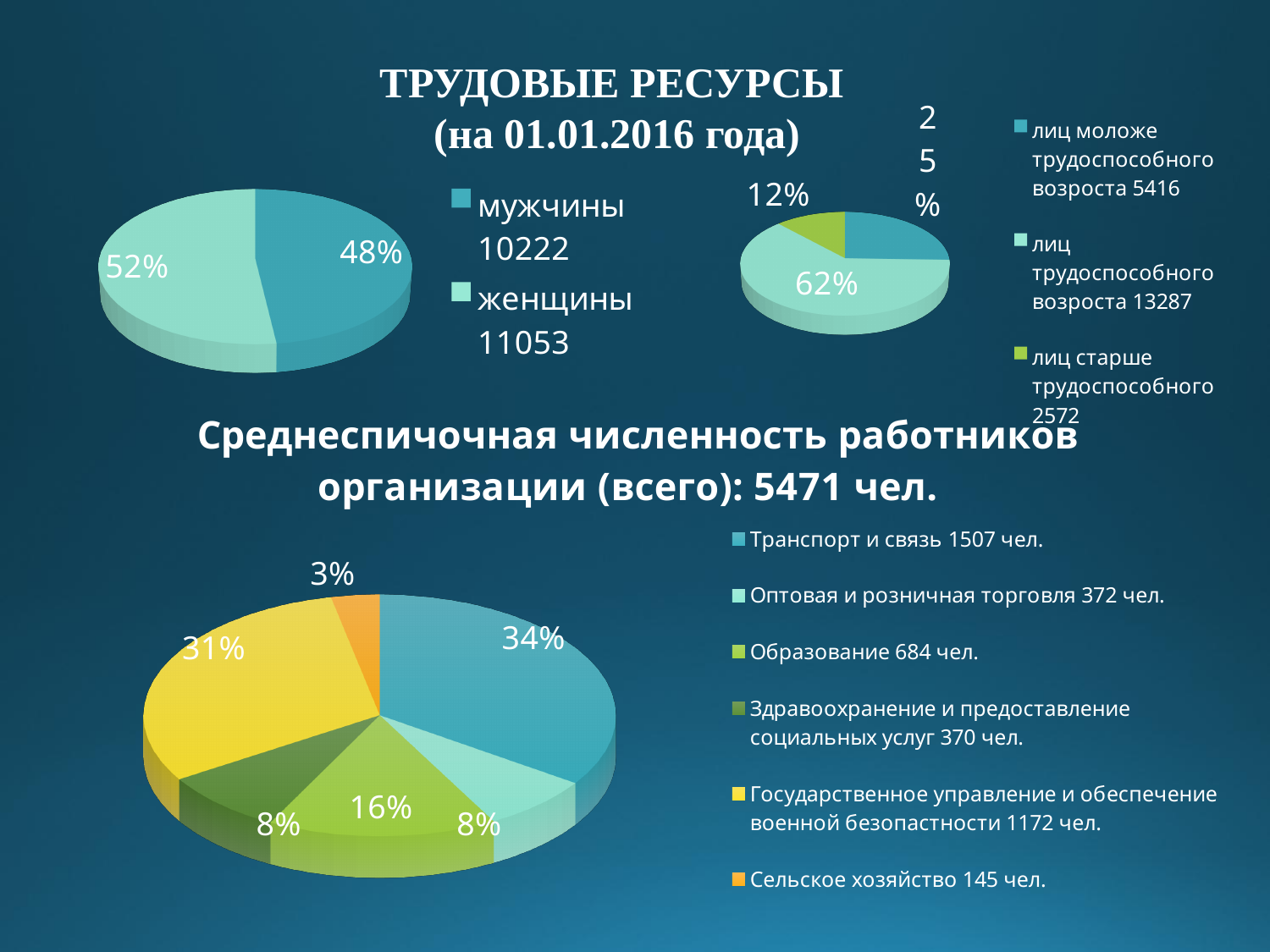
In the top-left pie chart, what share is labelled for мужчины? 48% In the bottom pie chart, which sector has the smallest share? Сельское хозяйство In the top-right pie chart, what share is labelled for лиц трудоспособного возроста? 62% In the bottom pie chart, what share is labelled for Транспорт и связь? 34% What type of chart is the bottom chart? pie chart In the top-right pie chart, how many categories does the legend list? 3 In the bottom pie chart, what is the difference in percentage points between Транспорт и связь and Государственное управление и обеспечение военной безопастности? 3 In the top-left pie chart, what number is given in the legend for мужчины? 10222 In the top-left pie chart, which group has the larger share, мужчины or женщины? женщины In the top-right pie chart, what share is labelled for лиц старше трудоспособного? 12% In the bottom pie chart, how many sectors does the legend list? 6 In the top-left pie chart, what share is labelled for женщины? 52%